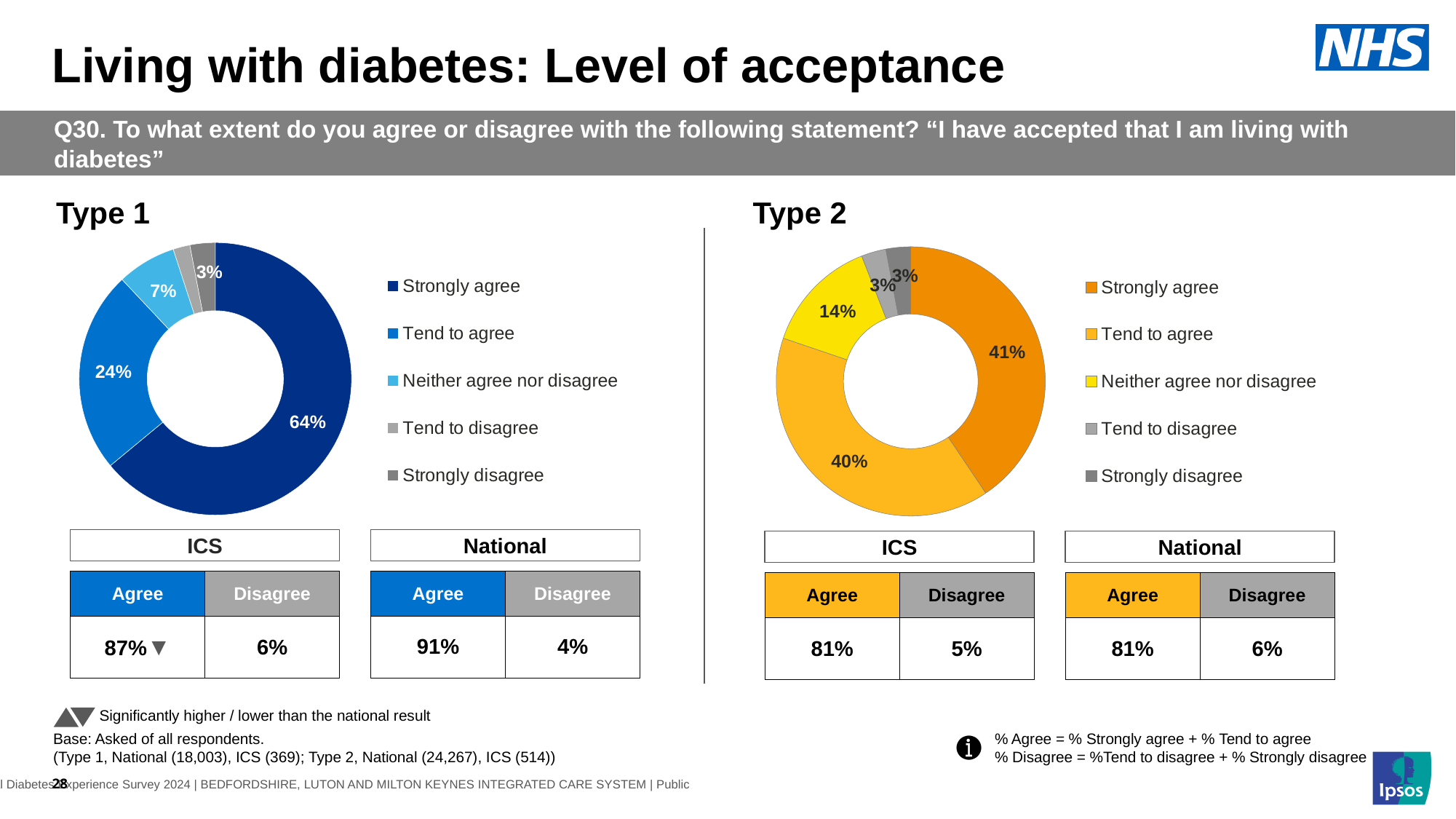
In the Type 1 chart, what percentage of respondents strongly agree? 64% In the Type 2 chart, what percentage neither agree nor disagree? 14% In the Type 1 chart, what percentage neither agree nor disagree? 7% How many response categories does the legend of the Type 2 chart list? 5 In the Type 2 chart, what percentage of respondents strongly agree? 41% In the Type 1 chart, which response category has the largest share? Strongly agree In the Type 2 chart, which response category has the largest share? Strongly agree What kind of chart is used for Type 1? Donut (pie) chart In the Type 1 chart, what percentage of respondents tend to agree? 24% In the Type 2 chart, what is the difference between the Strongly agree and Tend to agree shares? 1 percentage point In the Type 1 chart, what is the difference between the Strongly agree and Tend to agree shares? 40 percentage points Which is larger: the Strongly agree share in the Type 1 chart or in the Type 2 chart? Type 1